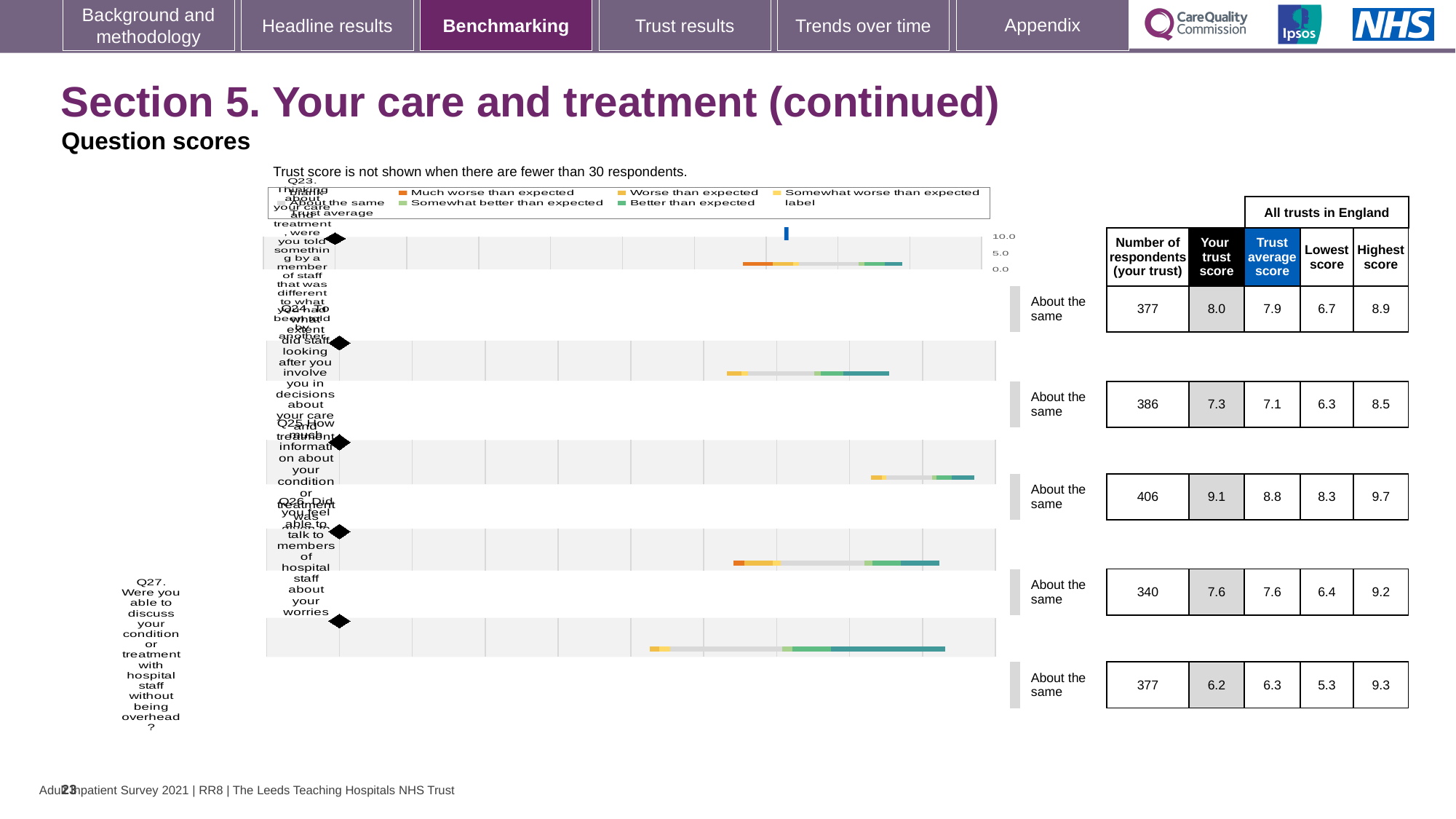
For Q27, which is larger: the 'Your trust score' or the 'Trust average score'? Trust average score What benchmark category is shown for Q23? About the same Which question has the highest 'Your trust score'? Q25 How many questions are plotted on the chart? 5 What is the difference between the 'Your trust score' and the 'Trust average score' for Q23? 0.1 What is the 'Your trust score' value for Q25 (How much information about your condition or treatment was given to you)? 9.1 Which question has the largest number of respondents (your trust)? Q25 What is the 'Highest score' across all trusts in England for Q25? 9.7 What kind of chart is used to show the question scores? Bar chart What is the difference between the 'Highest score' and the 'Lowest score' for Q24? 2.2 How many respondents (your trust) are shown for Q24? 386 Which question has the lowest 'Your trust score'? Q27